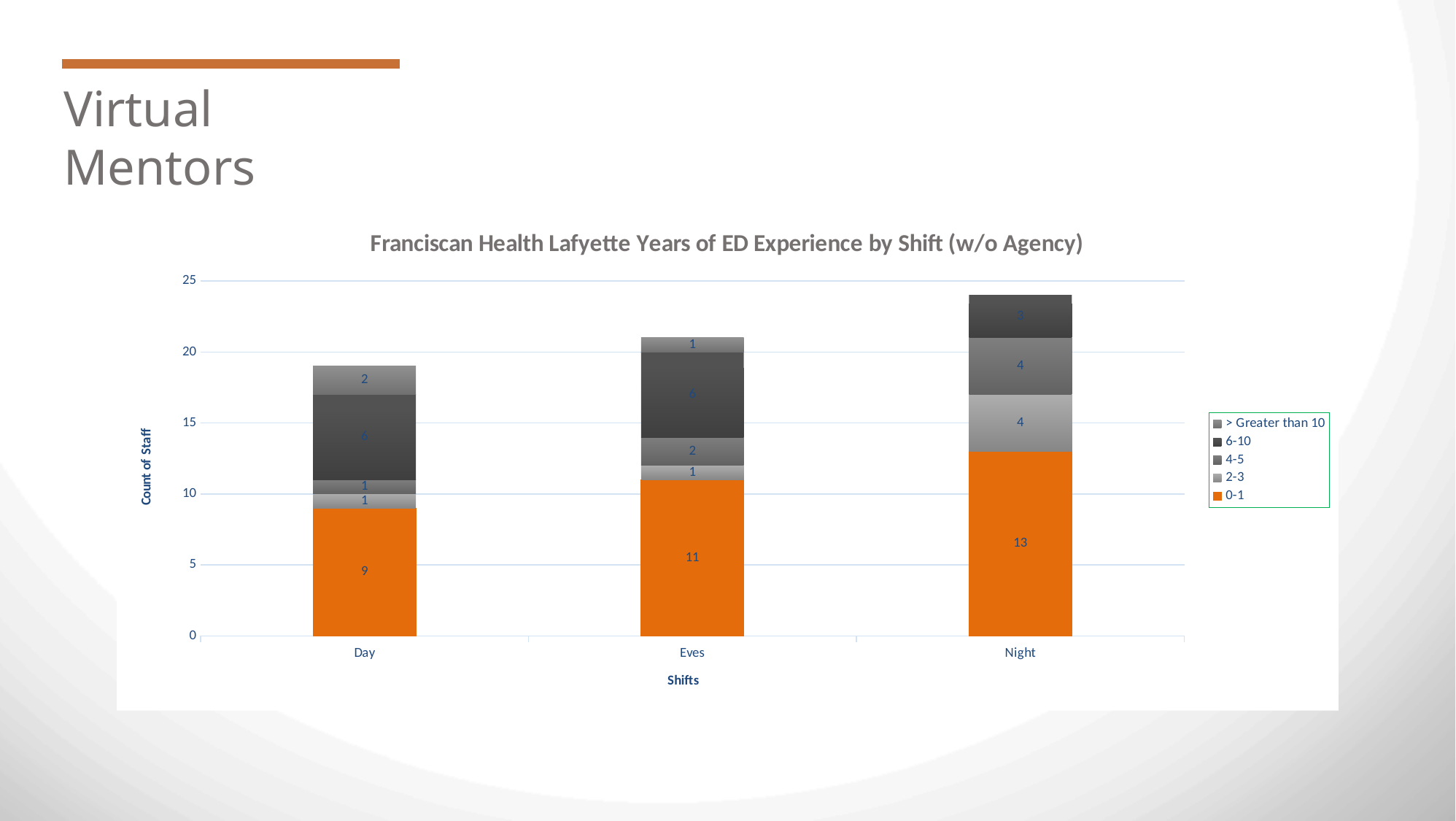
What is the value of the > Greater than 10 segment for the Day shift? 2 How many series does the legend list? 5 What kind of chart is shown on the slide? Stacked bar chart What is the value of the 0-1 segment for the Night shift? 13 Which shift has the highest value for the 0-1 series? Night What is the total of the stacked bar for the Eves shift? 21 What is the difference between the 0-1 values for Night and Day? 4 Which shift has the lowest value for the 0-1 series? Day What is the total of the stacked bar for the Day shift? 19 What is the value of the 6-10 segment for the Eves shift? 6 Which is larger, the 2-3 value for Night or the 2-3 value for Eves? Night How many shifts are shown on the x axis? 3